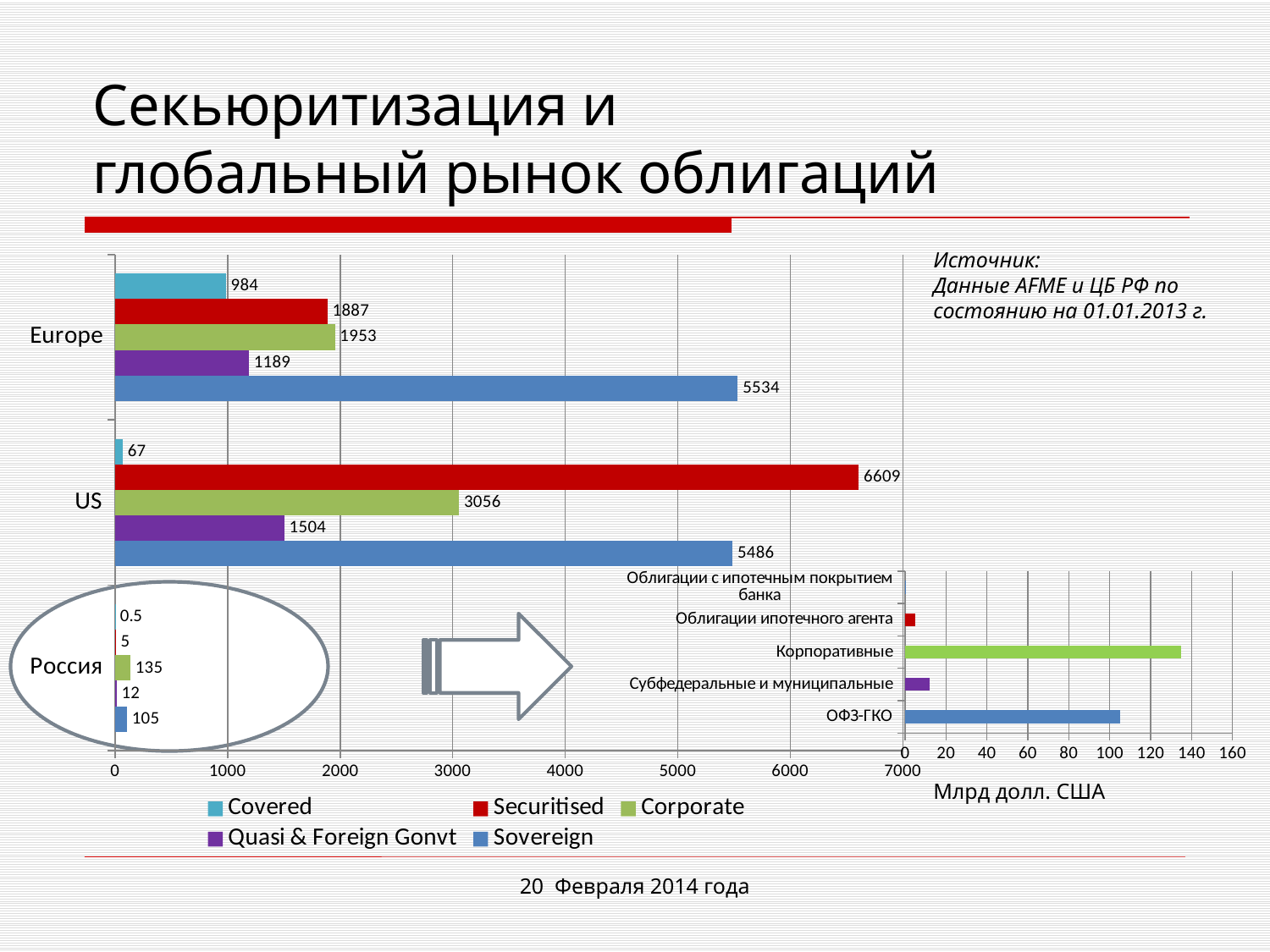
In the left chart, what is the difference between the Corporate and Securitised values for Europe? 66 In the right chart, is the value for Субфедеральные и муниципальные greater or less than 20? less How many regions (categories) are shown in the left chart? 3 In the left chart, what is the Corporate value for Россия? 135 In the right chart, is the value for Корпоративные greater or less than 120? greater How many series does the legend of the left chart list? 5 In the left chart, which series has the highest value for US? Securitised In the left chart, is the Sovereign value larger for Europe or for US? Europe In the left chart, what is the Securitised value for US? 6609 In the left chart, what is the Sovereign value for Europe? 5534 What kind of chart is the left chart? bar chart In the left chart, which series has the lowest value for Россия? Covered